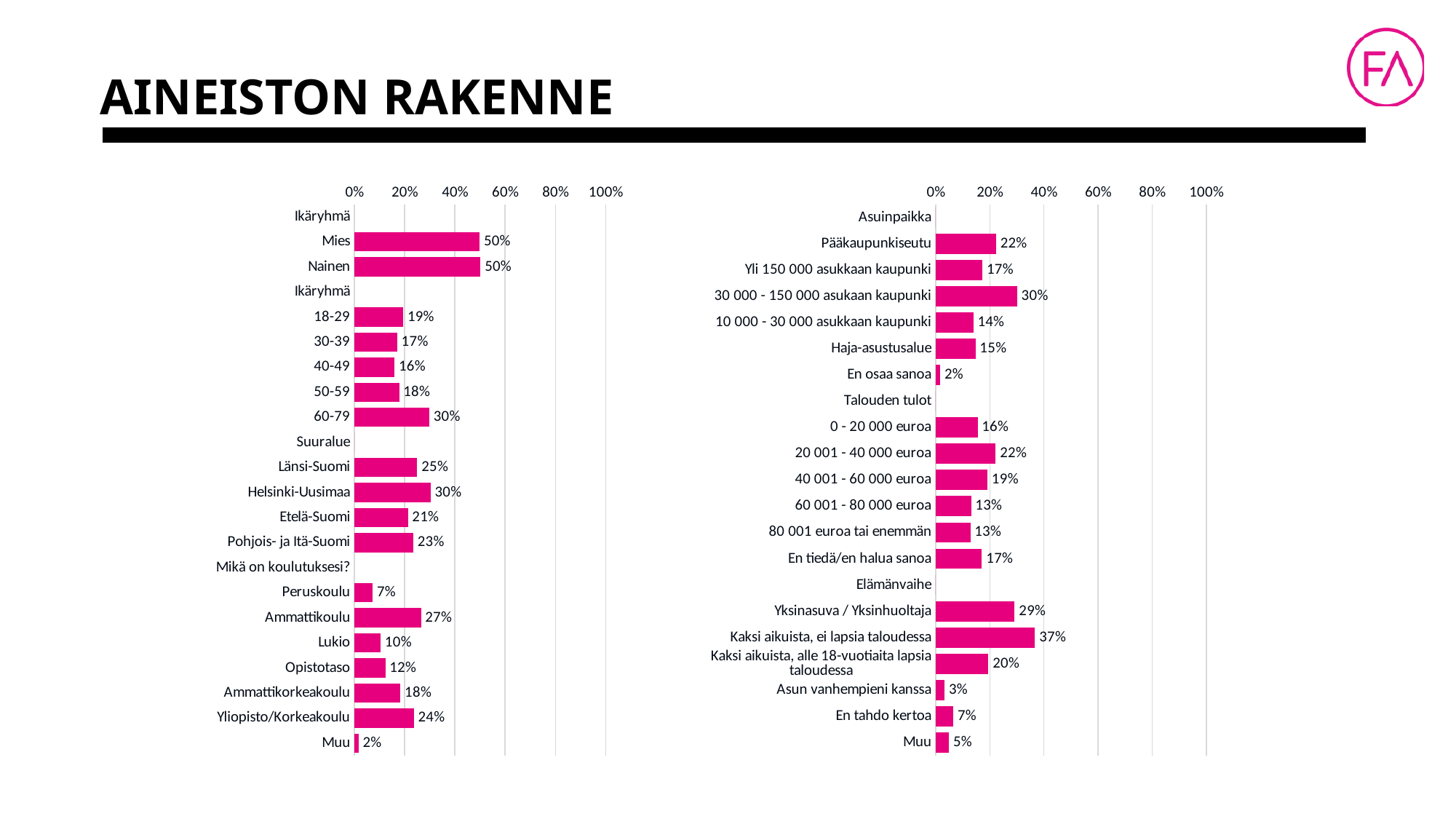
In the right chart, what is the value for Kaksi aikuista, ei lapsia taloudessa? 37% What kind of chart is shown on the left of the slide? Bar chart In the left chart, which education category (under Mikä on koulutuksesi?) has the lowest value? Muu In the right chart, what is the value for Pääkaupunkiseutu? 22% In the right chart, which is larger, Haja-asustusalue or 10 000 - 30 000 asukkaan kaupunki? Haja-asustusalue In the left chart, what is the value for the 60-79 age group? 30% In the right chart, how many Talouden tulot categories have bars? 6 In the right chart, which Asuinpaikka category has the highest value? 30 000 - 150 000 asukaan kaupunki In the left chart, what is the value for Ammattikoulu? 27% In the left chart, what is the difference between Helsinki-Uusimaa and Etelä-Suomi? 9% In the left chart, which is larger, Länsi-Suomi or Pohjois- ja Itä-Suomi? Länsi-Suomi In the right chart, what is the difference between Yksinasuva / Yksinhuoltaja and Asun vanhempieni kanssa? 26%